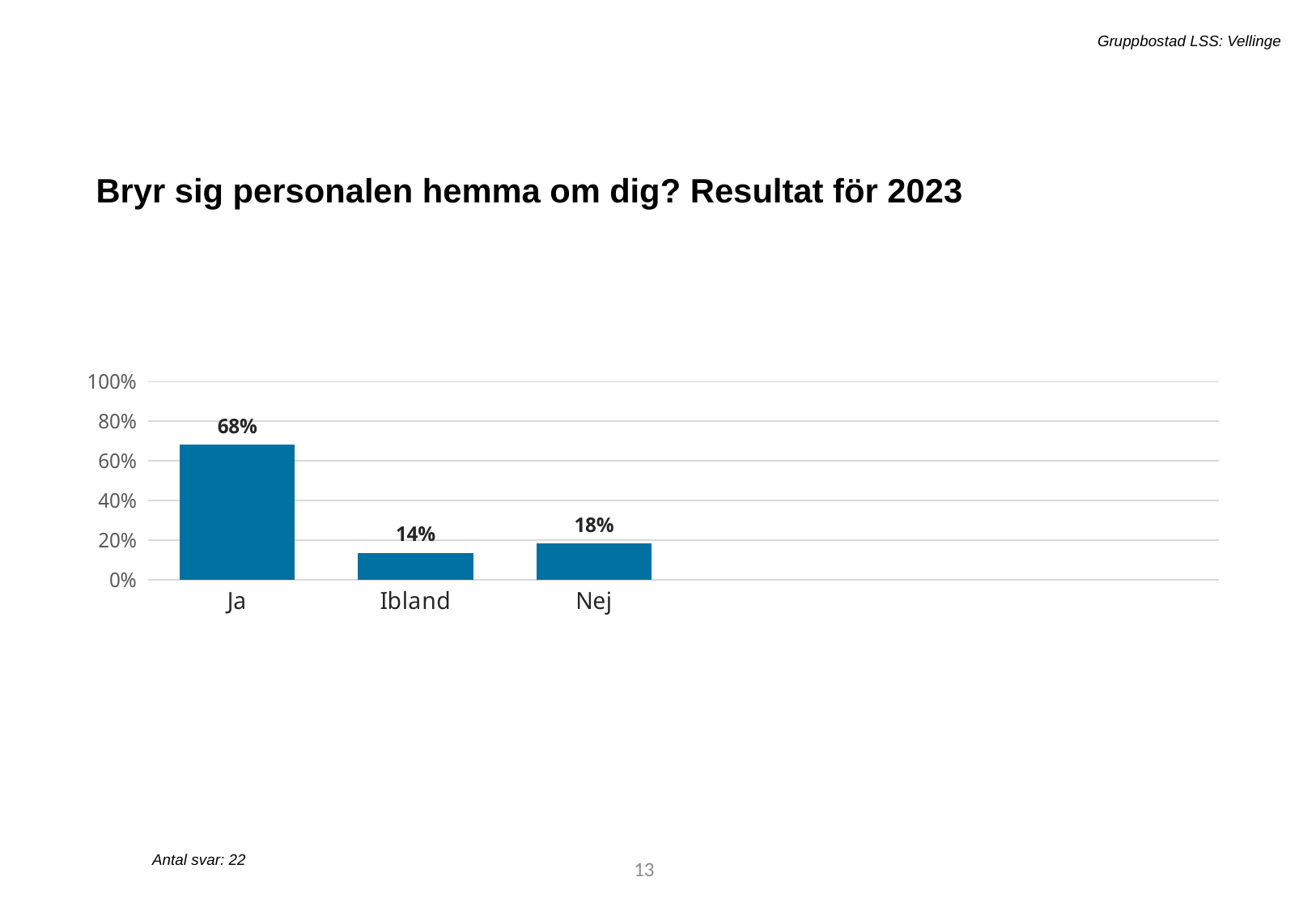
What is the value for Ibland? 14% What is the difference between the values for Ja and Nej? 50% How many categories are shown on the x axis? 3 What kind of chart is shown on the slide? bar chart Which category has the lowest value? Ibland What is the value for Nej? 18% Is the value for Ja greater or less than 60%? greater Which category has the highest value? Ja What is the difference between the values for Nej and Ibland? 4% What is the value for Ja? 68% What is the title of the slide? Bryr sig personalen hemma om dig? Resultat för 2023 Which is larger, the value for Ibland or the value for Nej? Nej